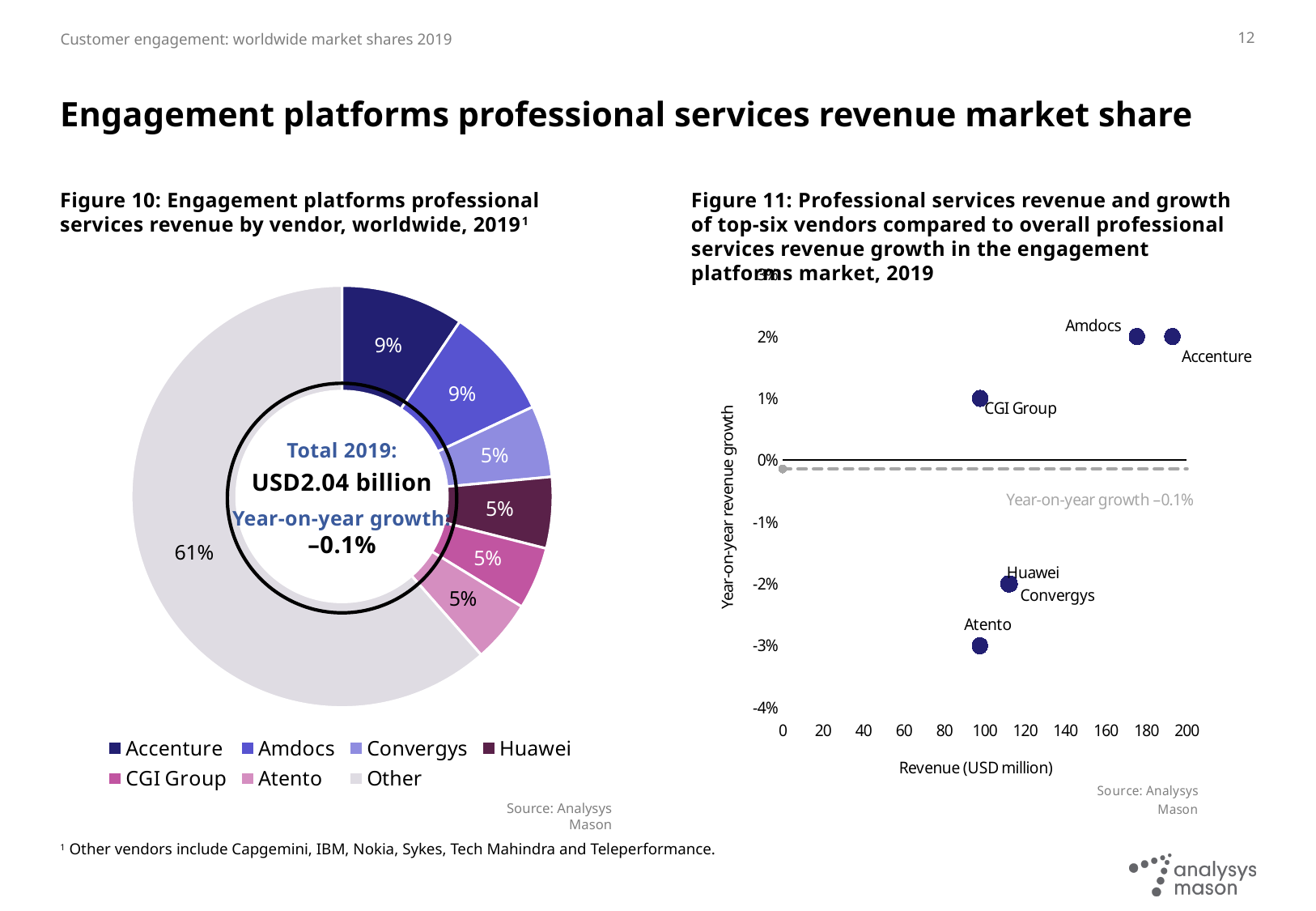
In Figure 10, what is the total 2019 revenue shown in the centre of the chart? USD2.04 billion How many entries does the legend of Figure 10 list? 7 In Figure 10, what year-on-year growth is shown in the centre of the chart? –0.1% In Figure 10, what share of revenue does Accenture hold? 9% In Figure 10, what share of engagement platforms professional services revenue is attributed to Other vendors? 61% What kind of chart is Figure 11? Scatter chart In Figure 10, how many percentage points larger is the Other share than the Amdocs share? 52 percentage points In Figure 11, which vendor has the lowest year-on-year revenue growth? Atento What kind of chart is Figure 10? Pie (donut) chart In Figure 11, is the revenue for Accenture greater or less than 180 USD million? greater In Figure 10, which segment has the largest share? Other In Figure 11, is the year-on-year revenue growth for Atento greater or less than -2%? less